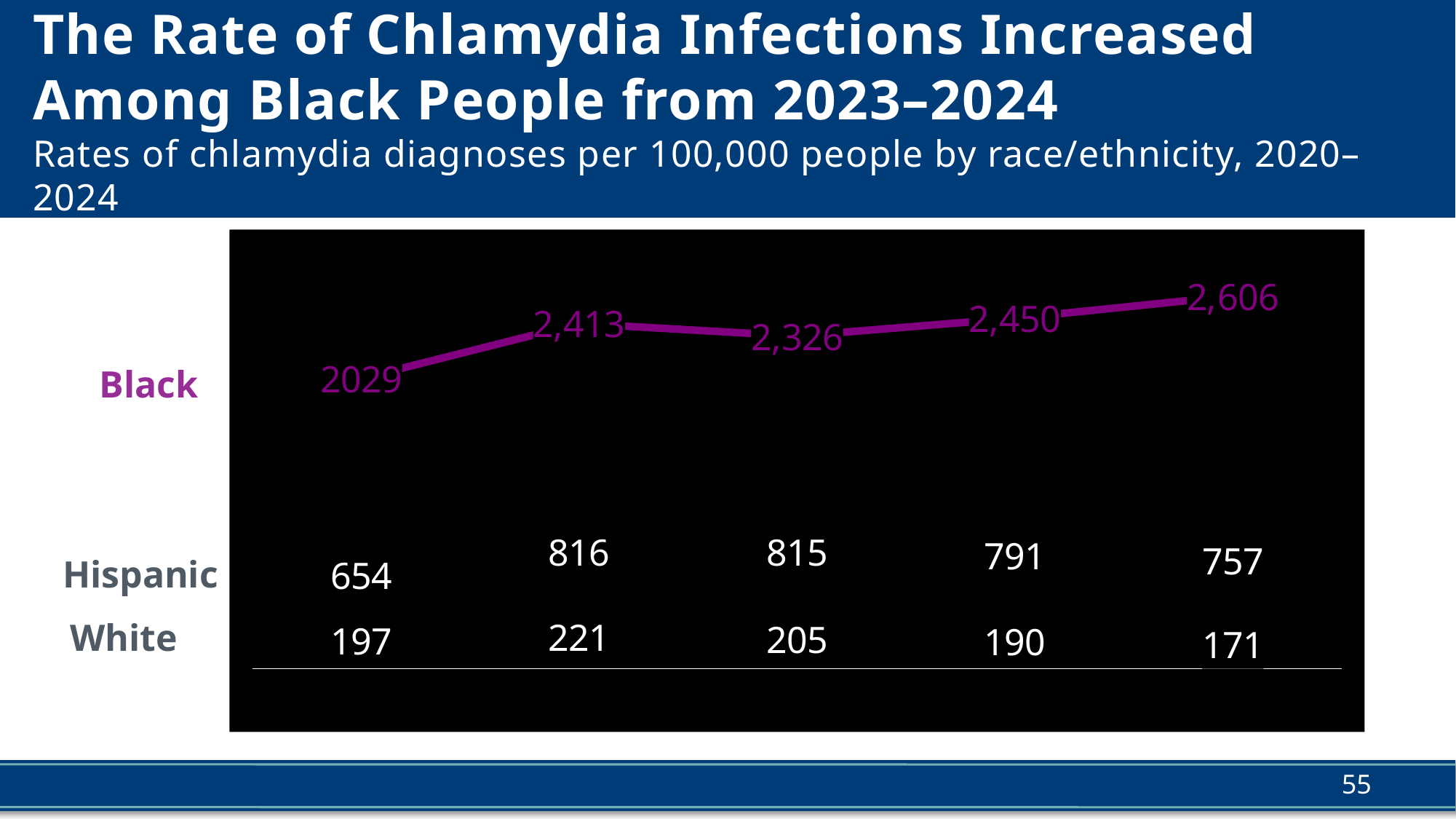
How many data points does each series have? 5 What is the highest value on the Black series? 2,606 What kind of chart is this? line chart How many series are shown on the chart? 3 What is the second value shown for the Hispanic series? 816 Does the Black series rise or fall from its first point to its last point? rise What is the difference between the last and first values of the Black series? 577 What is the last value shown for the White series? 171 What is the value of the leftmost point on the Black series? 2029 Which is larger on the Black series, the second value (2,413) or the third value (2,326)? 2,413 What is the value of the rightmost point on the Black series? 2,606 What is the lowest value shown for the White series? 171